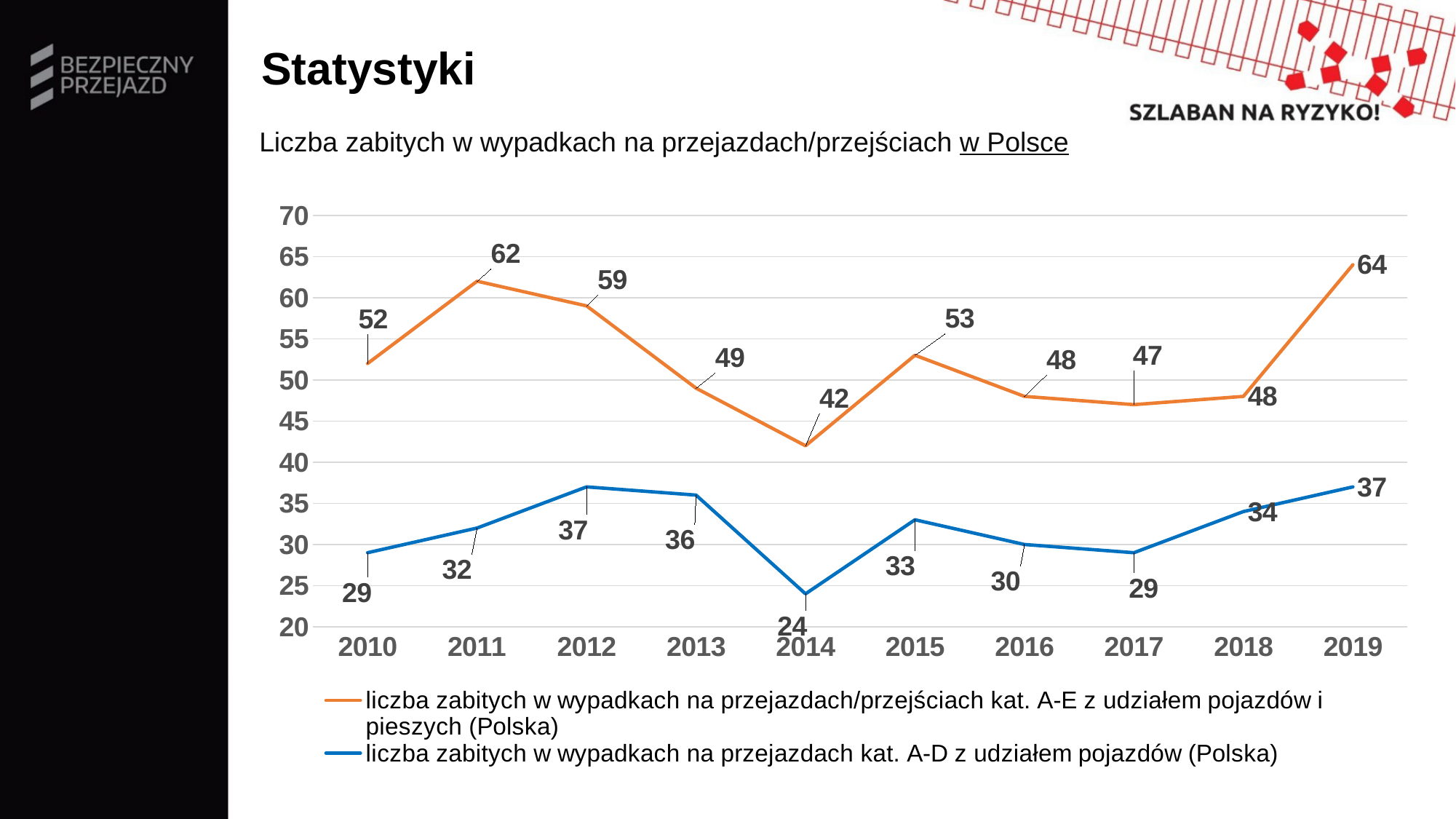
How many years are plotted on the x axis? 10 In which year is the blue series (kat. A-D) lowest? 2014 How many series does the legend list? 2 What colour is the line for the kat. A-D series? blue In which year is the orange series (kat. A-E) highest? 2019 What type of chart is shown on the slide? line chart What is the difference between the orange series and the blue series in 2019? 27 What is the value of the orange series (kat. A-E) in 2015? 53 Which is larger: the orange series value in 2012 or in 2013? 2012 What is the value of the orange series (kat. A-E) in 2011? 62 Does the blue series (kat. A-D) rise or fall from 2017 to 2019? rise What is the value of the blue series (kat. A-D) in 2014? 24